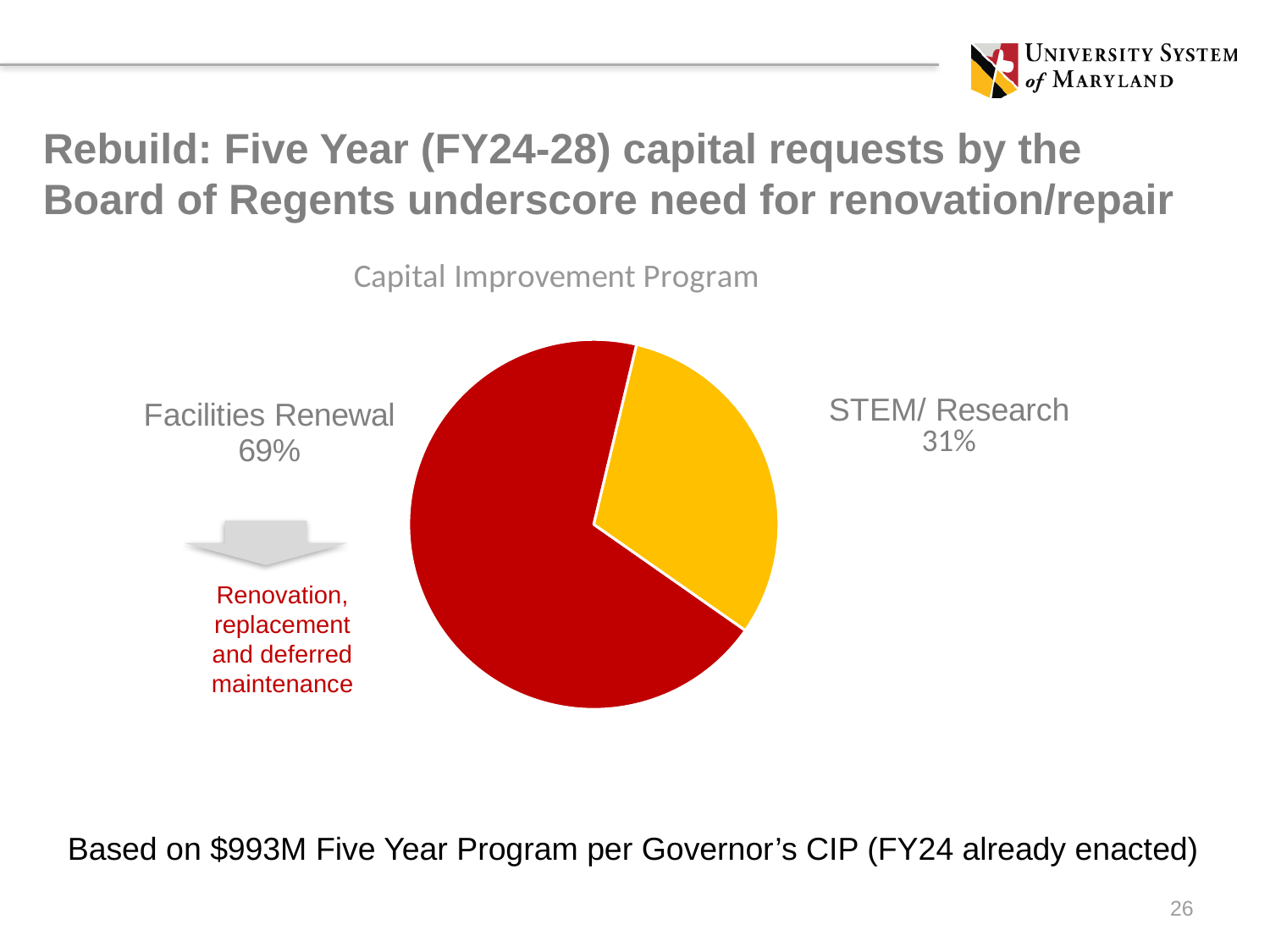
What is the difference in percentage points between Facilities Renewal and STEM/ Research? 38 What colour is the Facilities Renewal slice? Red Which slice of the pie is the largest? Facilities Renewal Which is larger, Facilities Renewal or STEM/ Research? Facilities Renewal Which slice of the pie is the smallest? STEM/ Research Is the share for STEM/ Research greater or less than 50%? less What kind of chart is shown on the slide? Pie chart What is the title of the chart? Capital Improvement Program How many slices does the pie chart have? 2 What share of the pie is STEM/ Research? 31% What share of the pie is Facilities Renewal? 69%